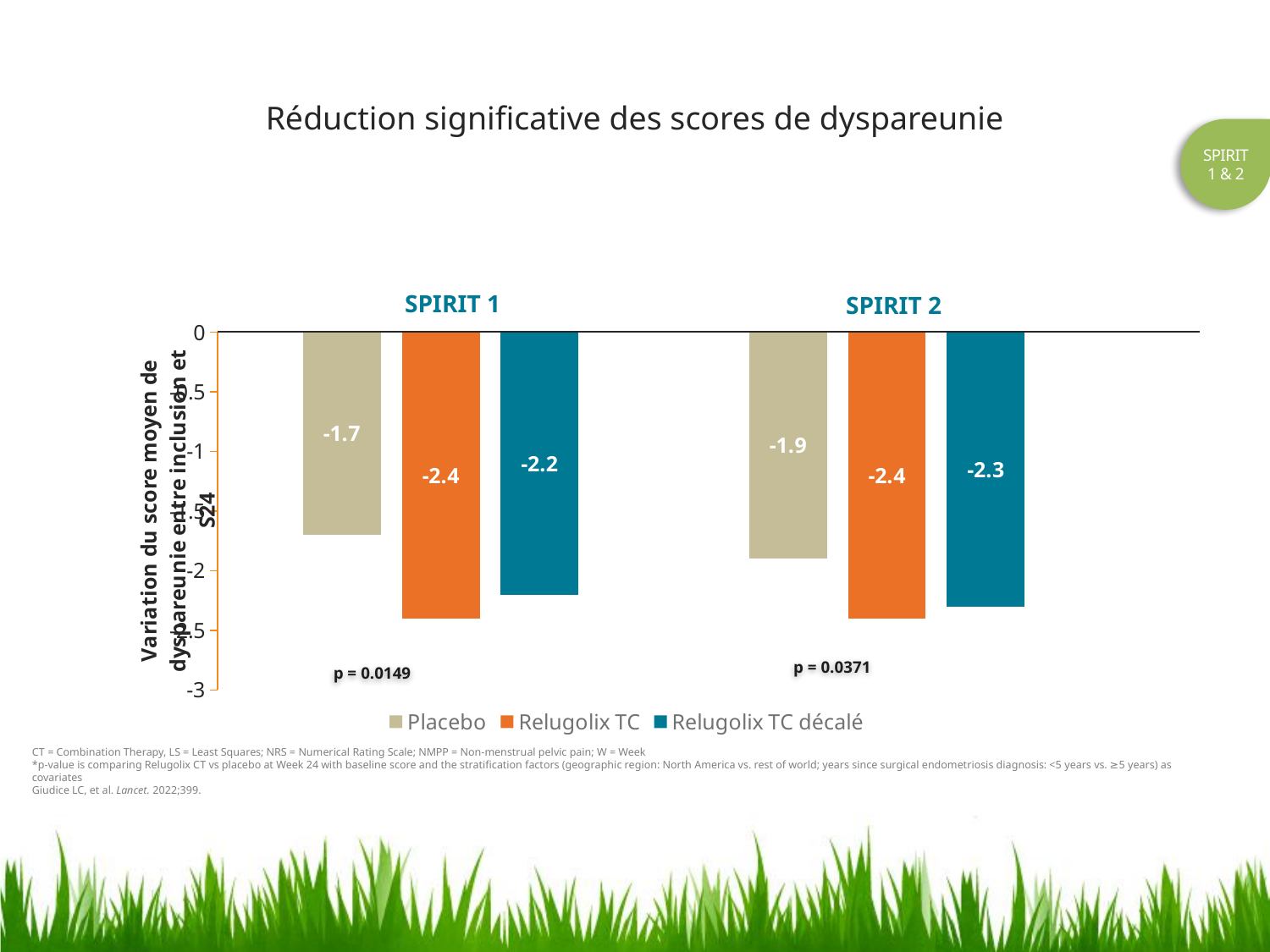
What is the value for Relugolix TC in SPIRIT 2? -2.4 Which shows a larger reduction in SPIRIT 1: Relugolix TC or Relugolix TC décalé? Relugolix TC How many series does the legend list? 3 Which series has the largest reduction (most negative value) in SPIRIT 2? Relugolix TC What kind of chart is shown on the slide? Bar chart What p-value is shown for SPIRIT 2? p = 0.0371 Which series has the smallest reduction (least negative value) in SPIRIT 1? Placebo What is the value for Placebo in SPIRIT 1? -1.7 What is the value for Relugolix TC décalé in SPIRIT 1? -2.2 What is the difference between the Relugolix TC and Placebo values in SPIRIT 1? 0.7 What is the value for Placebo in SPIRIT 2? -1.9 What is the difference between the Relugolix TC décalé and Placebo values in SPIRIT 2? 0.4